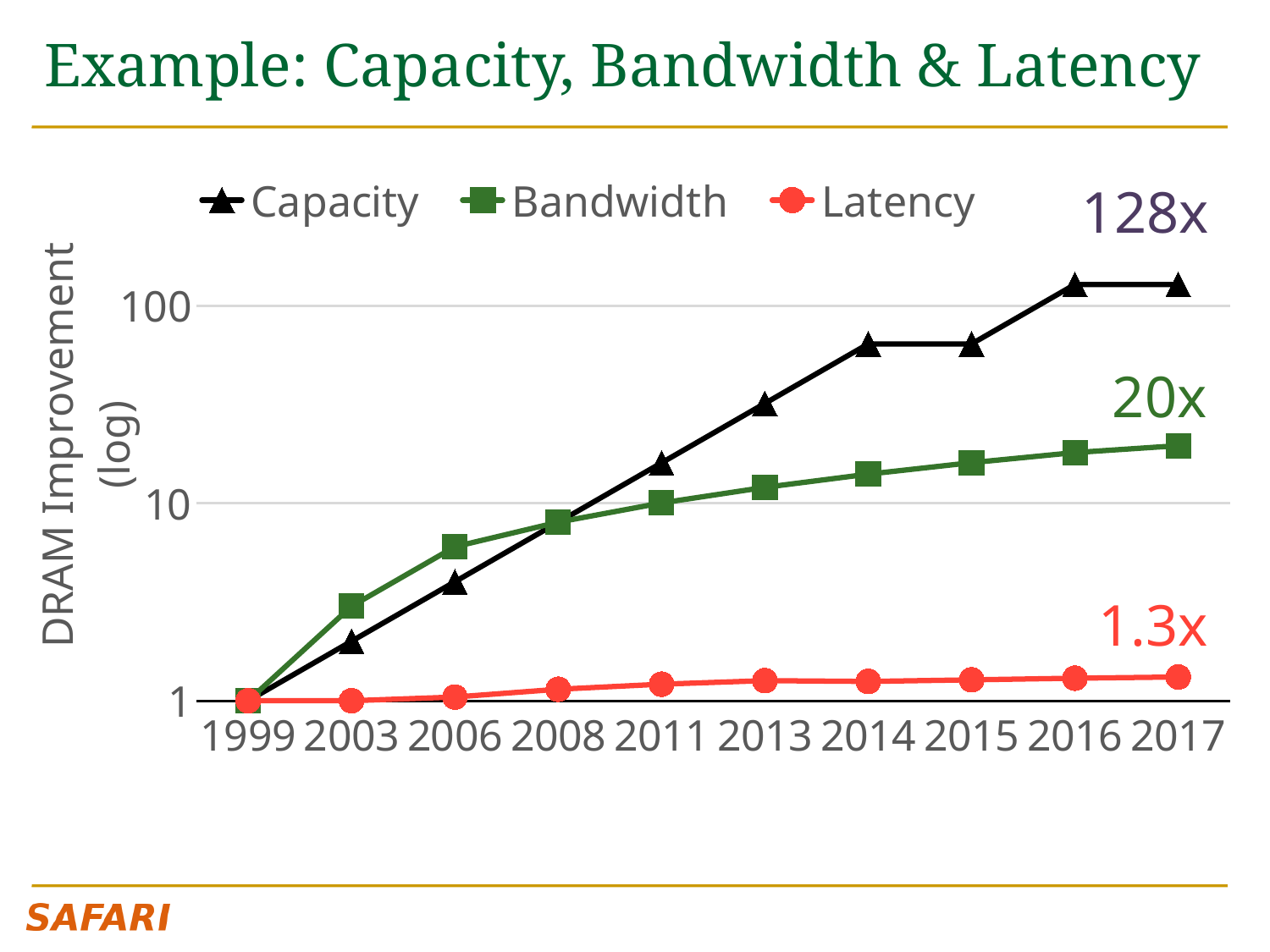
What kind of chart is shown on the slide? line chart Which series has the highest value in 2017? Capacity How many series does the legend list? 3 What is the label on the y axis? DRAM Improvement (log) How many years are shown along the x axis? 10 What is the Capacity improvement value labelled at 2017? 128x Which series has the lowest value in 2017? Latency Does the Capacity series rise or fall from 1999 to 2017? rise What is the Latency improvement value labelled at 2017? 1.3x Is the Capacity value for 2013 greater or less than 10? greater What is the Bandwidth improvement value labelled at 2017? 20x In 2006, which is larger: Bandwidth or Capacity? Bandwidth